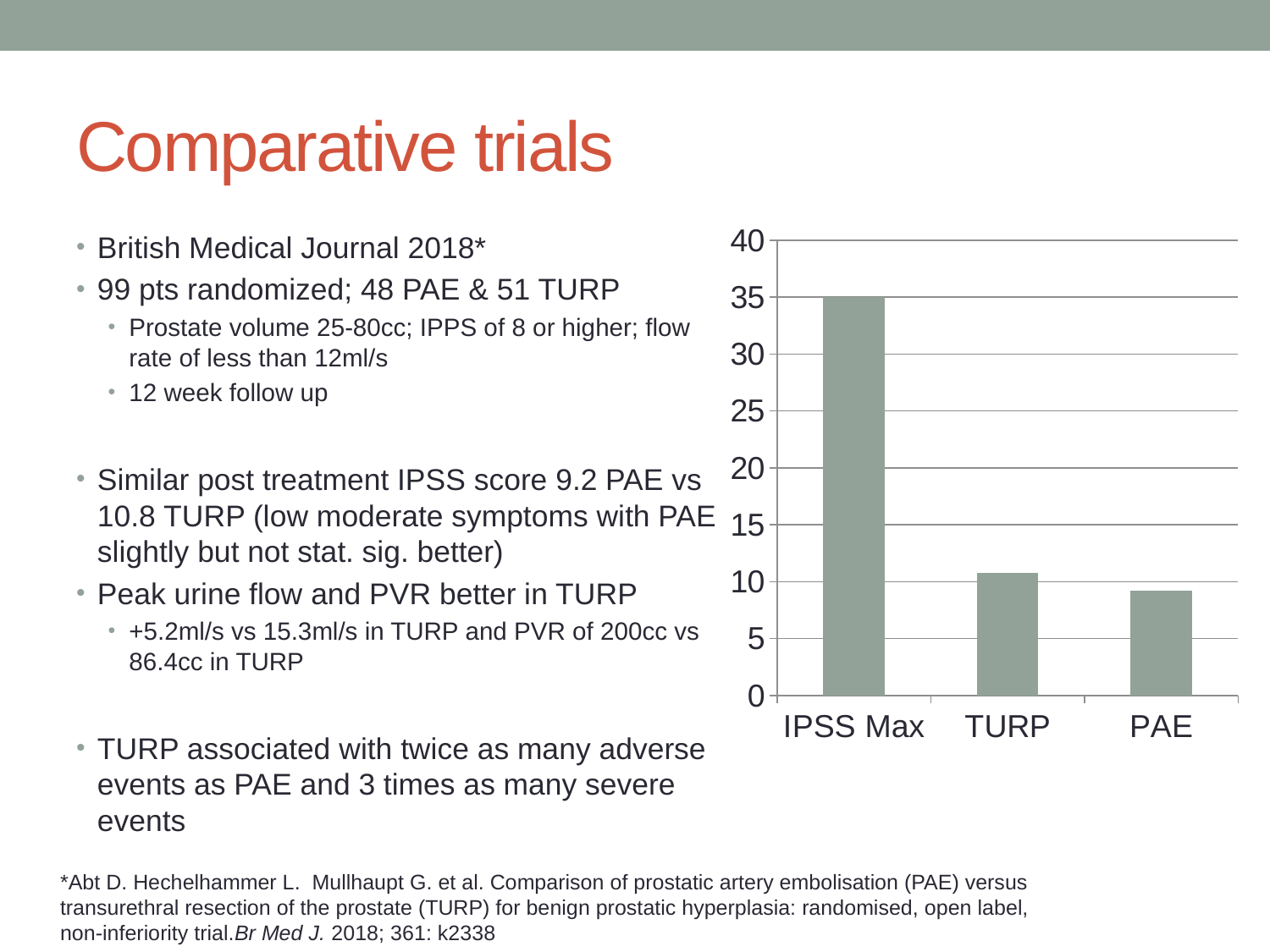
What kind of chart is shown on the slide? bar chart Do the bar values rise or fall from left to right across the x axis? fall Is the value for IPSS Max greater or less than 30? greater What is the value of the IPSS Max bar? 35 How many categories are shown on the x axis of the chart? 3 Is the value for PAE greater or less than 15? less Is the value for PAE greater or less than 5? greater Which category has the lowest bar in the chart? PAE Which bar is taller, TURP or PAE? TURP Which category has the highest bar in the chart? IPSS Max What is the highest value shown on the chart's vertical axis? 40